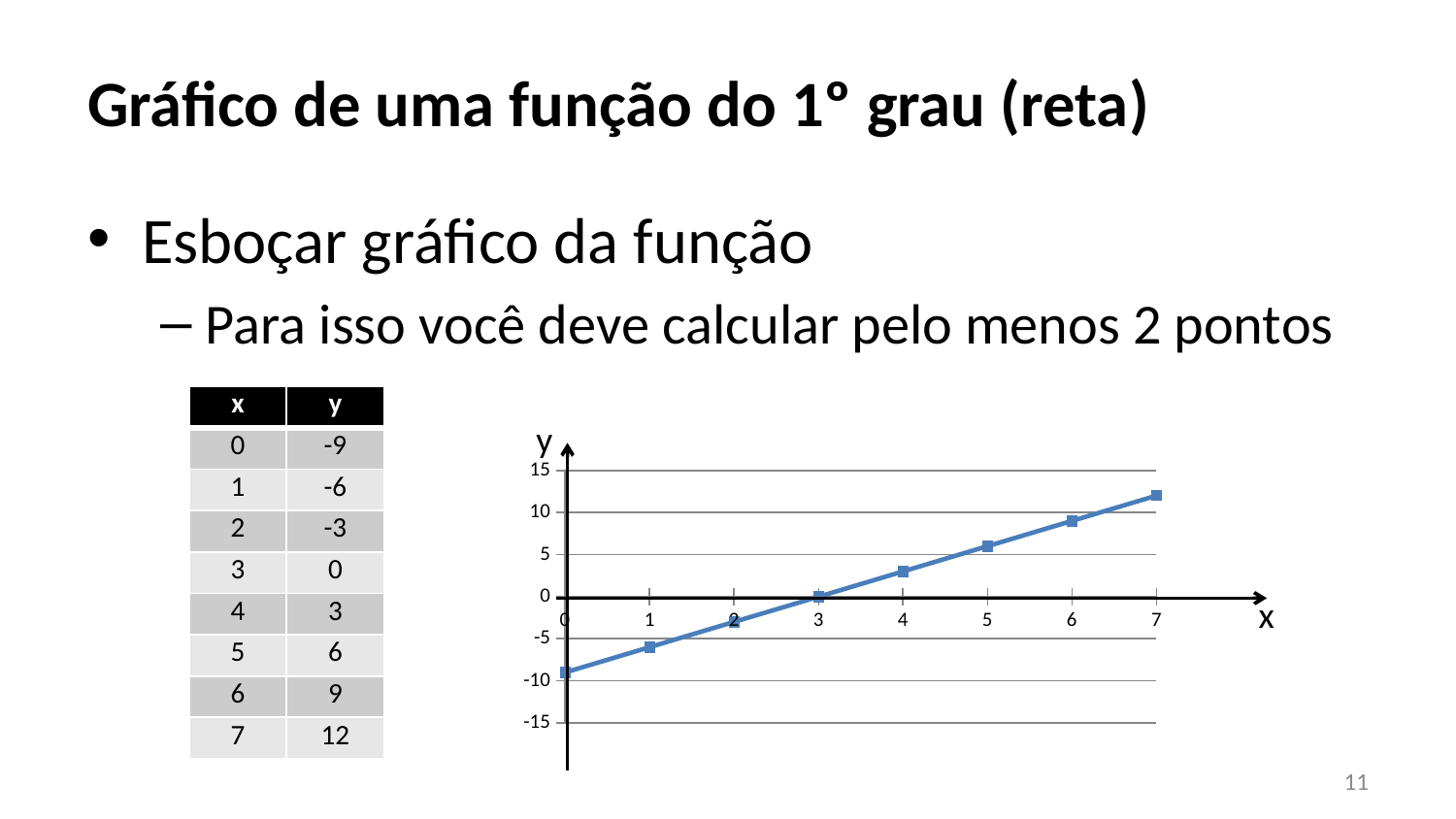
At which x value is y lowest? 0 What kind of chart is shown on the slide? line chart What is the value of y when x = 0? -9 At which x value is y highest? 7 How many data points are plotted on the line? 8 Is the value of y at x = 1 greater or less than 0? less What is the value of y when x = 3? 0 Is the value of y at x = 6 greater or less than 5? greater What is the difference between the y value at x = 7 and the y value at x = 0? 21 What is the value of y when x = 7? 12 Which is larger, the y value at x = 5 or the y value at x = 2? x = 5 Do the y values rise or fall as x increases along the x axis? rise